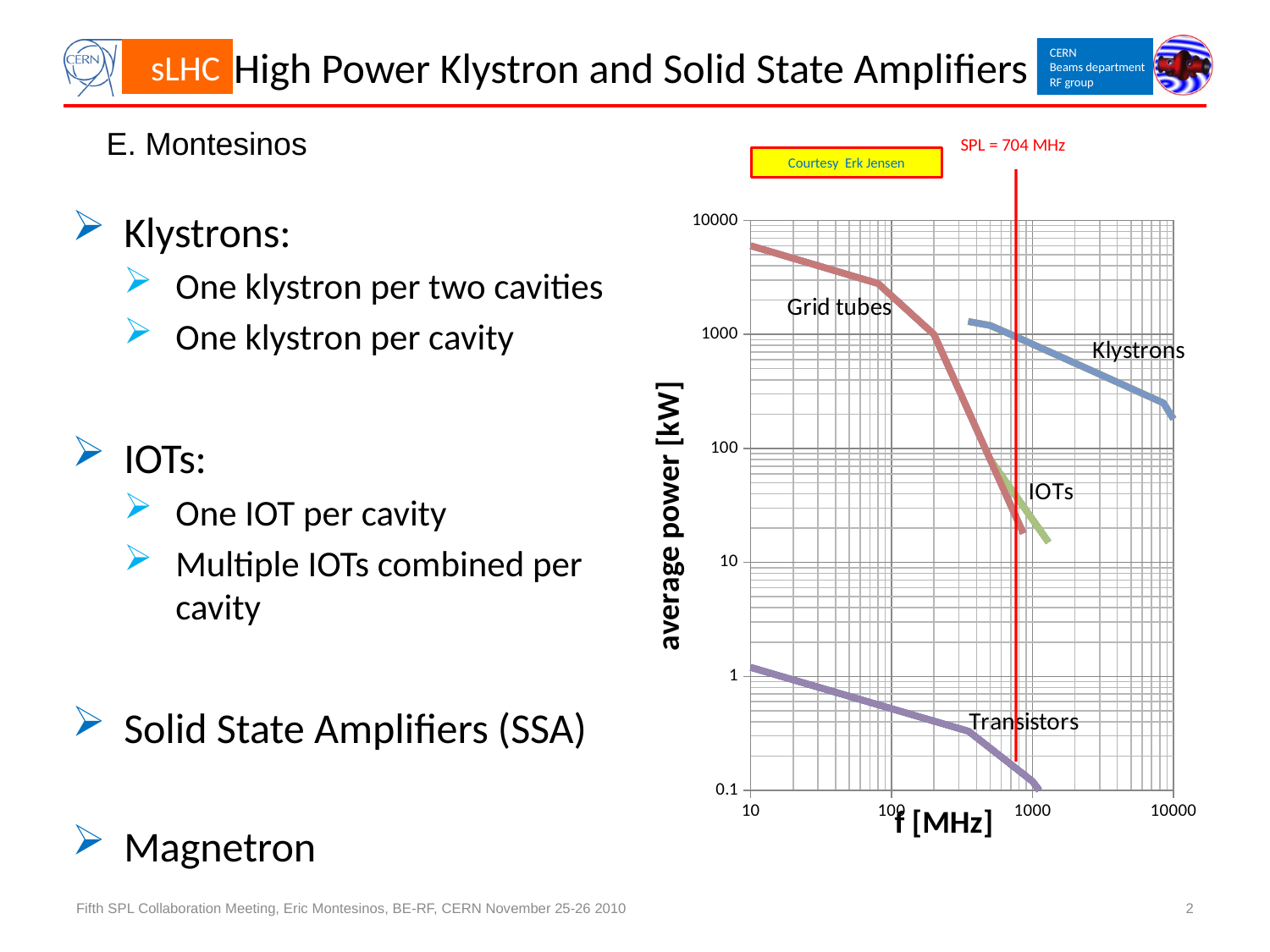
At 1000 MHz, which curve shows higher average power, Klystrons or Transistors? Klystrons What is the label of the x axis of the chart? f [MHz] Which curve reaches the highest average power on the chart? Grid tubes Is the average power of Klystrons at 10000 MHz greater or less than 100 kW? greater Is the average power of Grid tubes at 10 MHz greater or less than 1000 kW? greater How many labelled curves are plotted on the chart? 4 Does the Klystrons curve rise or fall as frequency increases? fall What kind of chart is shown on the slide? line chart Which curve has the lowest average power on the chart? Transistors Is the average power of Transistors at 100 MHz greater or less than 1 kW? less What is the label of the y axis of the chart? average power [kW] Does the average power of the Grid tubes curve rise or fall as frequency increases? fall